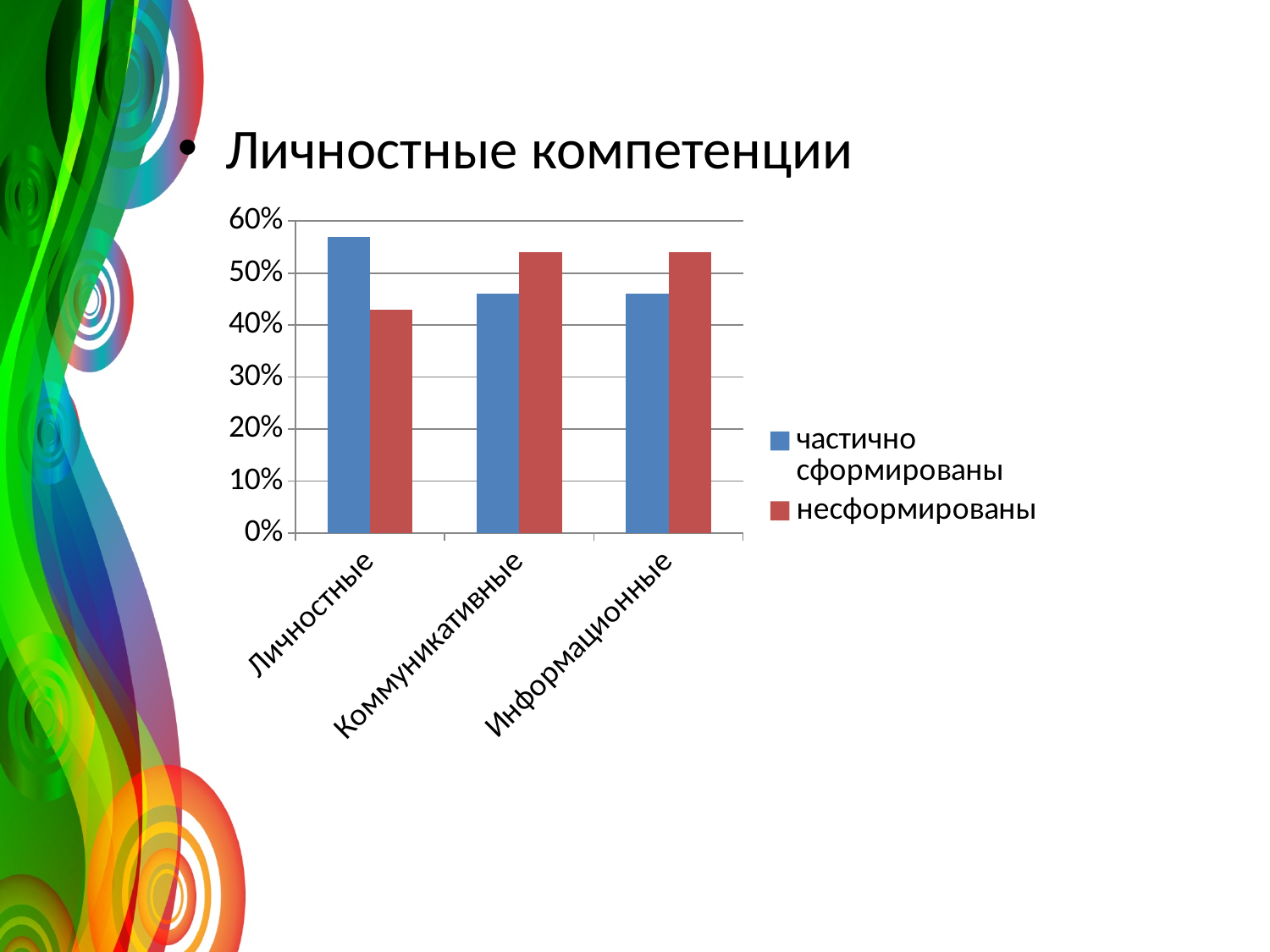
Is the value for 'несформированы' in the 'Личностные' category greater or less than 50%? less What kind of chart is shown on the slide? bar chart How many categories are shown on the x axis of the chart? 3 In the 'Личностные' category, which series has the larger value: 'частично сформированы' or 'несформированы'? частично сформированы Is the value for 'частично сформированы' in the 'Информационные' category greater or less than 50%? less In the 'Коммуникативные' category, which series has the larger value: 'частично сформированы' or 'несформированы'? несформированы What colour are the bars for the 'несформированы' series? red Which category has the lowest value for the 'несформированы' series? Личностные How many series does the chart legend list? 2 Is the value for 'частично сформированы' in the 'Личностные' category greater or less than 50%? greater Which category has the highest value for the 'частично сформированы' series? Личностные